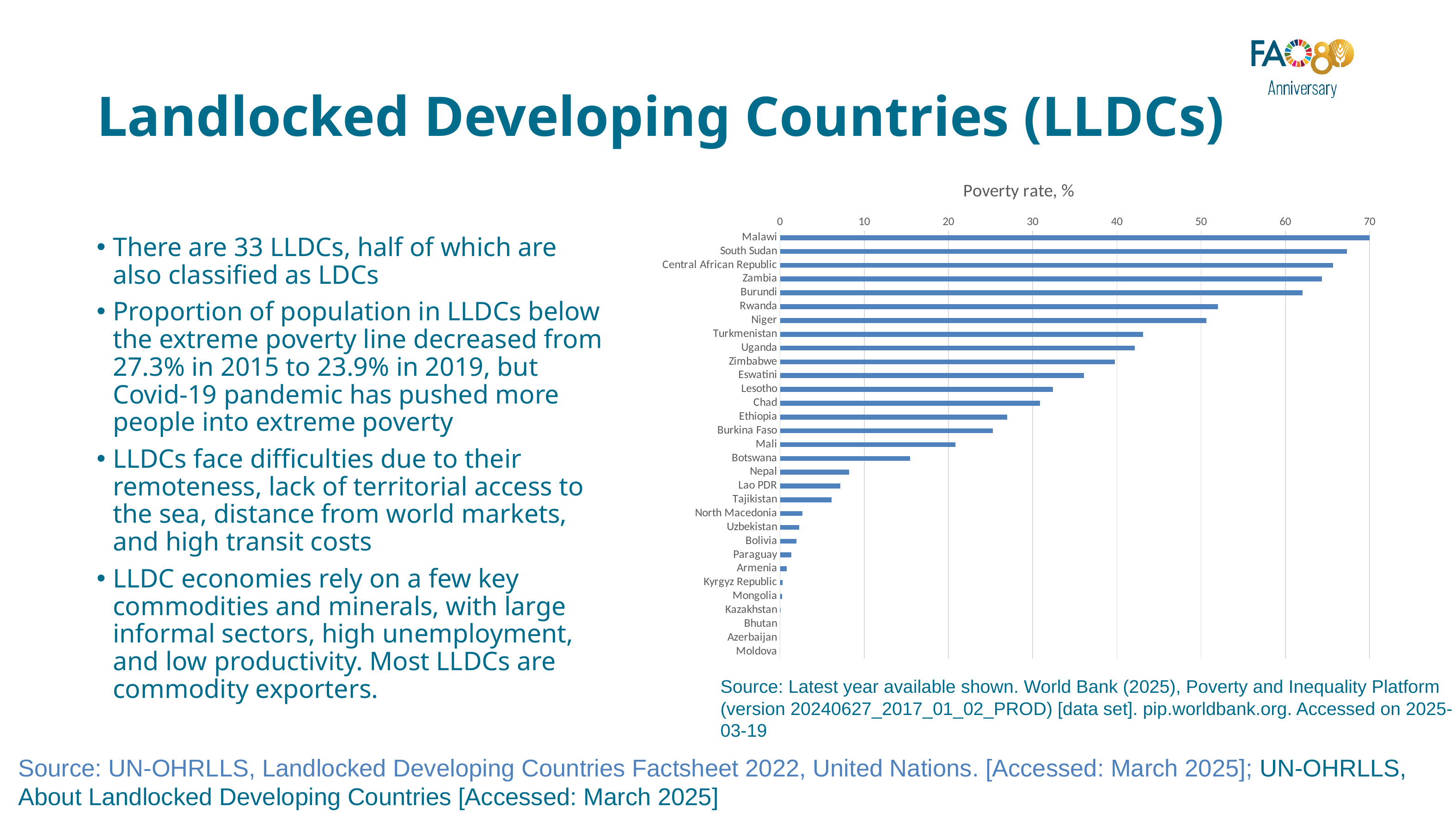
Do the poverty rates rise or fall going down the list of countries from Malawi to Moldova? fall Is the poverty rate for Rwanda greater or less than 50? greater How many countries are listed in the chart? 31 What kind of chart is shown on the slide? bar chart Which country has the highest poverty rate in the chart? Malawi Is the poverty rate for Nepal greater or less than 10? less Is the poverty rate for Ethiopia greater or less than 30? less What is the title of the chart? Poverty rate, % Which has a higher poverty rate, Zambia or Burundi? Zambia